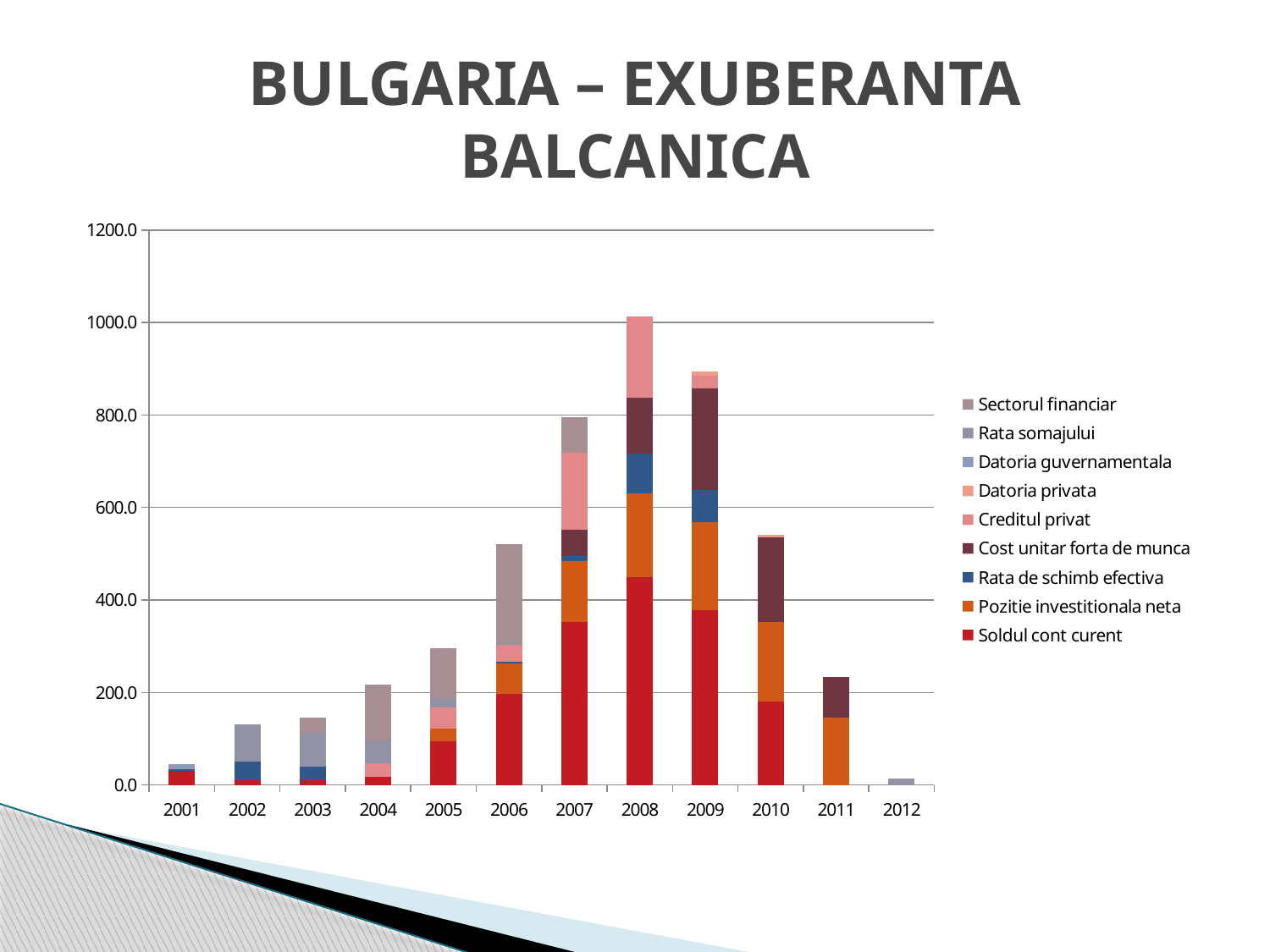
Do the stacked bar totals rise or fall from 2001 to 2008? rise Which year has the shortest stacked bar? 2012 Which year has the taller stacked bar, 2006 or 2007? 2007 What kind of chart is shown on the slide? Stacked bar chart Is the total height of the stacked bar for 2010 greater or less than 600? less Which year has the taller stacked bar, 2008 or 2009? 2008 How many series does the chart's legend list? 9 How many years are shown on the x axis of the chart? 12 Is the total height of the stacked bar for 2008 greater or less than 800? greater Which year has the tallest stacked bar? 2008 Is the total height of the stacked bar for 2005 greater or less than 200? greater Which series is listed last (at the bottom) in the chart's legend? Soldul cont curent